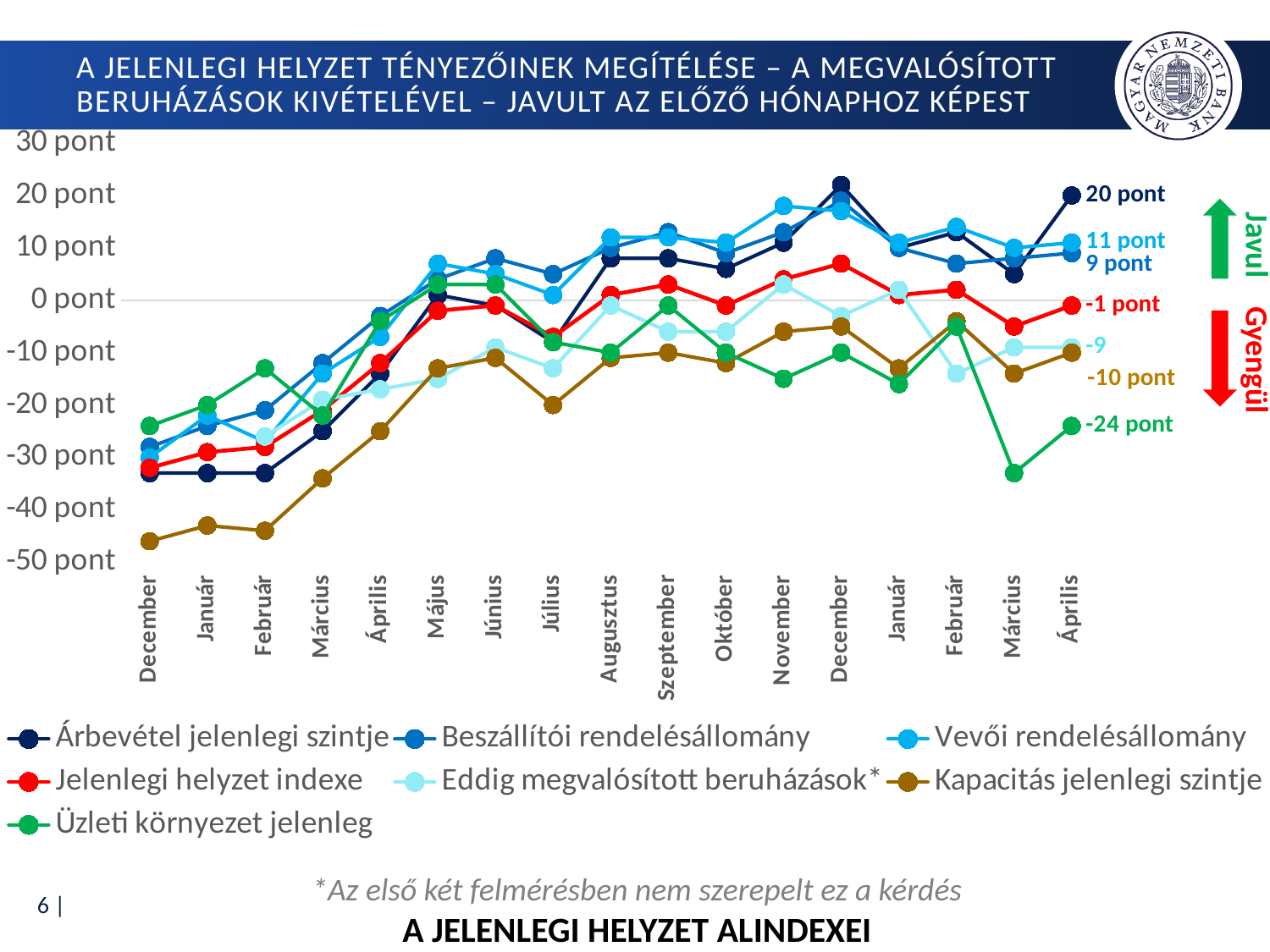
Is the value of Kapacitás jelenlegi szintje in the first December greater or less than -40 pont? less What is the value of Árbevétel jelenlegi szintje in the final Április? 20 pont Does Árbevétel jelenlegi szintje rise or fall from the first December to the final Április? rise What type of chart is shown on the slide? line chart What is the value of Jelenlegi helyzet indexe in the final Április? -1 pont Which series has the highest value in the final Április? Árbevétel jelenlegi szintje What is the value of Üzleti környezet jelenleg in the final Április? -24 pont How many series does the legend list? 7 What is the value of Kapacitás jelenlegi szintje in the final Április? -10 pont How many months are shown along the x axis? 17 Which series has the lowest value in the final Április? Üzleti környezet jelenleg What is the difference between the final Április values of Árbevétel jelenlegi szintje and Üzleti környezet jelenleg? 44 pont